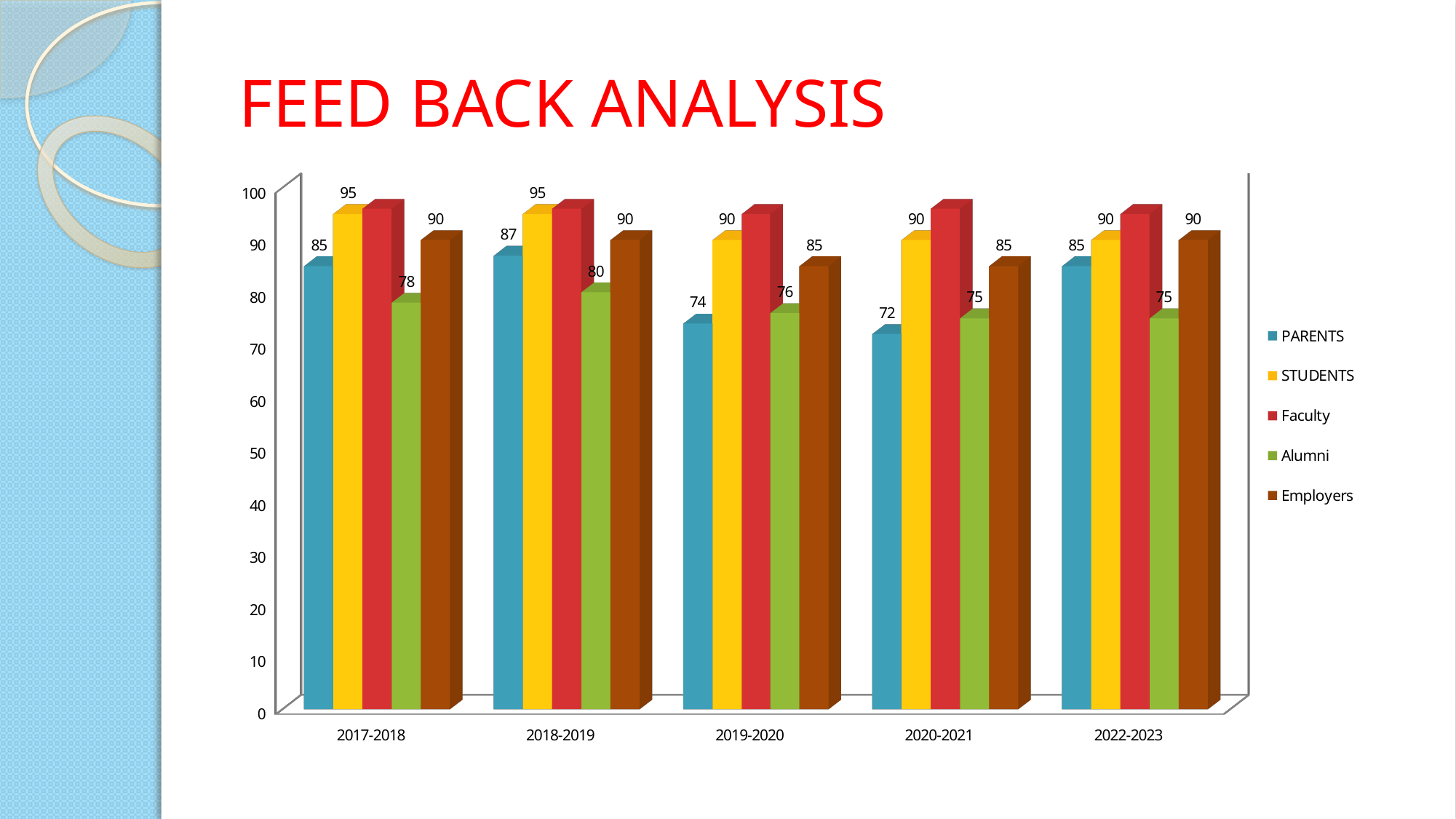
What kind of chart is shown on the slide? bar chart Do the PARENTS values rise or fall from 2018-2019 to 2020-2021? fall What is the value for Employers in 2020-2021? 85 What is the value for PARENTS in 2019-2020? 74 In which year is the Alumni value highest? 2018-2019 How many series does the legend list? 5 How many year categories are shown on the x axis? 5 In which year is the PARENTS value lowest? 2020-2021 What is the value for Alumni in 2018-2019? 80 What is the difference between the STUDENTS and PARENTS values in 2020-2021? 18 In 2017-2018, which is larger: the Employers value or the Alumni value? Employers Is the value for Faculty in 2017-2018 greater or less than 80? greater